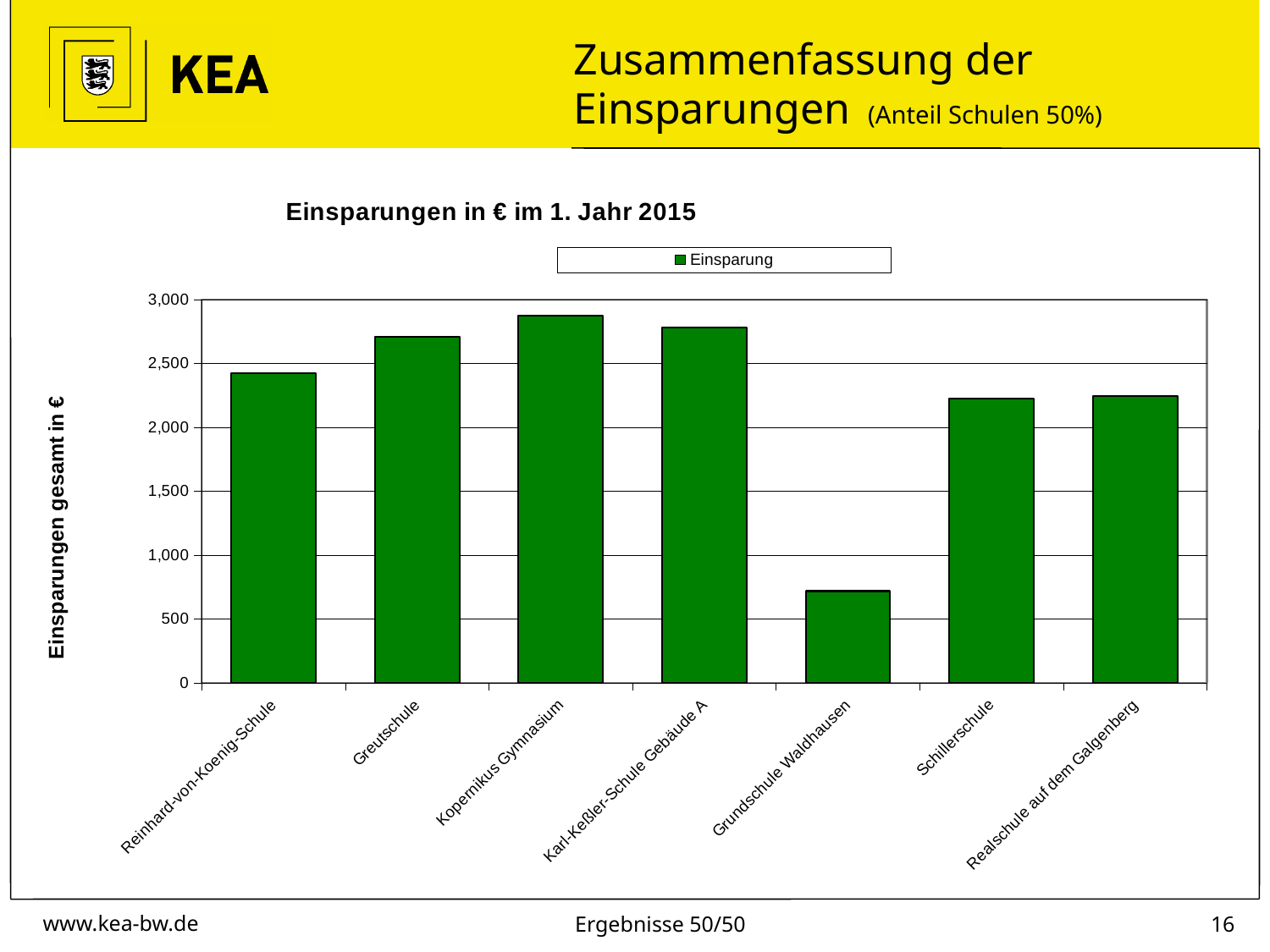
Which school has the highest Einsparung in the chart? Kopernikus Gymnasium Which has the larger Einsparung, Greutschule or Reinhard-von-Koenig-Schule? Greutschule What kind of chart is shown on the slide? bar chart Which school has the lowest Einsparung in the chart? Grundschule Waldhausen What is the label of the chart's vertical axis? Einsparungen gesamt in € Is the value for Kopernikus Gymnasium greater or less than 2,500? greater Is the value for Reinhard-von-Koenig-Schule greater or less than 2,000? greater How many series does the chart legend list? 1 Is the value for Grundschule Waldhausen greater or less than 1,000? less How many schools (categories) are shown on the x axis of the chart? 7 What is the title of the chart? Einsparungen in € im 1. Jahr 2015